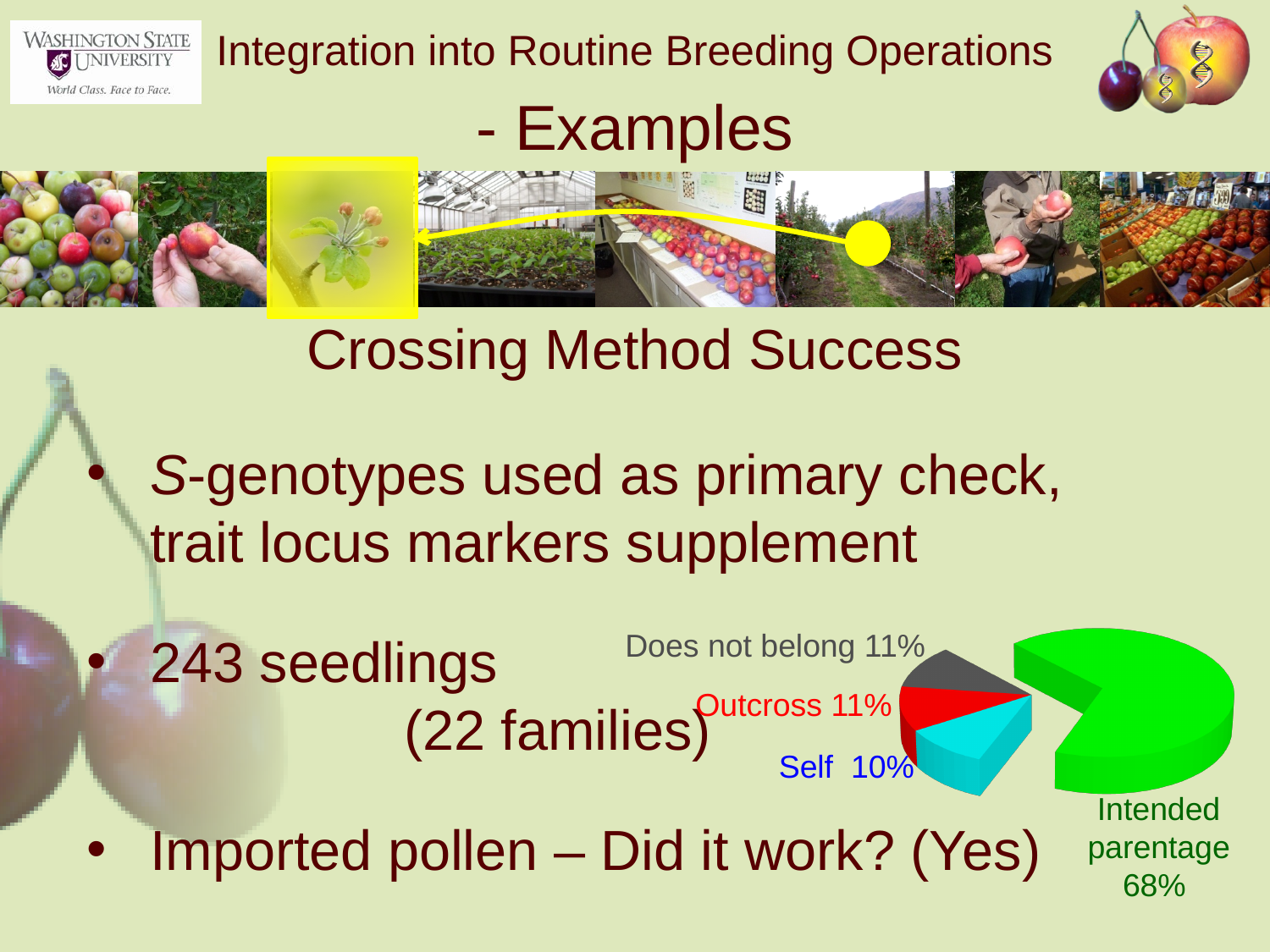
How many slices does the pie chart have? 4 What is the difference in percentage points between Outcross and Self in the pie chart? 1 What percentage does the Self slice represent in the pie chart? 10% What kind of chart is shown on the slide? Pie chart What share of the pie chart is labelled Intended parentage? 68% Which slice of the pie chart is the largest? Intended parentage What colour is the Intended parentage slice in the pie chart? Green What percentage does the Does not belong slice represent in the pie chart? 11% Which is larger in the pie chart, Intended parentage or Self? Intended parentage What percentage does the Outcross slice represent in the pie chart? 11% Which slice of the pie chart is the smallest? Self What is the difference in percentage points between Intended parentage and Self in the pie chart? 58